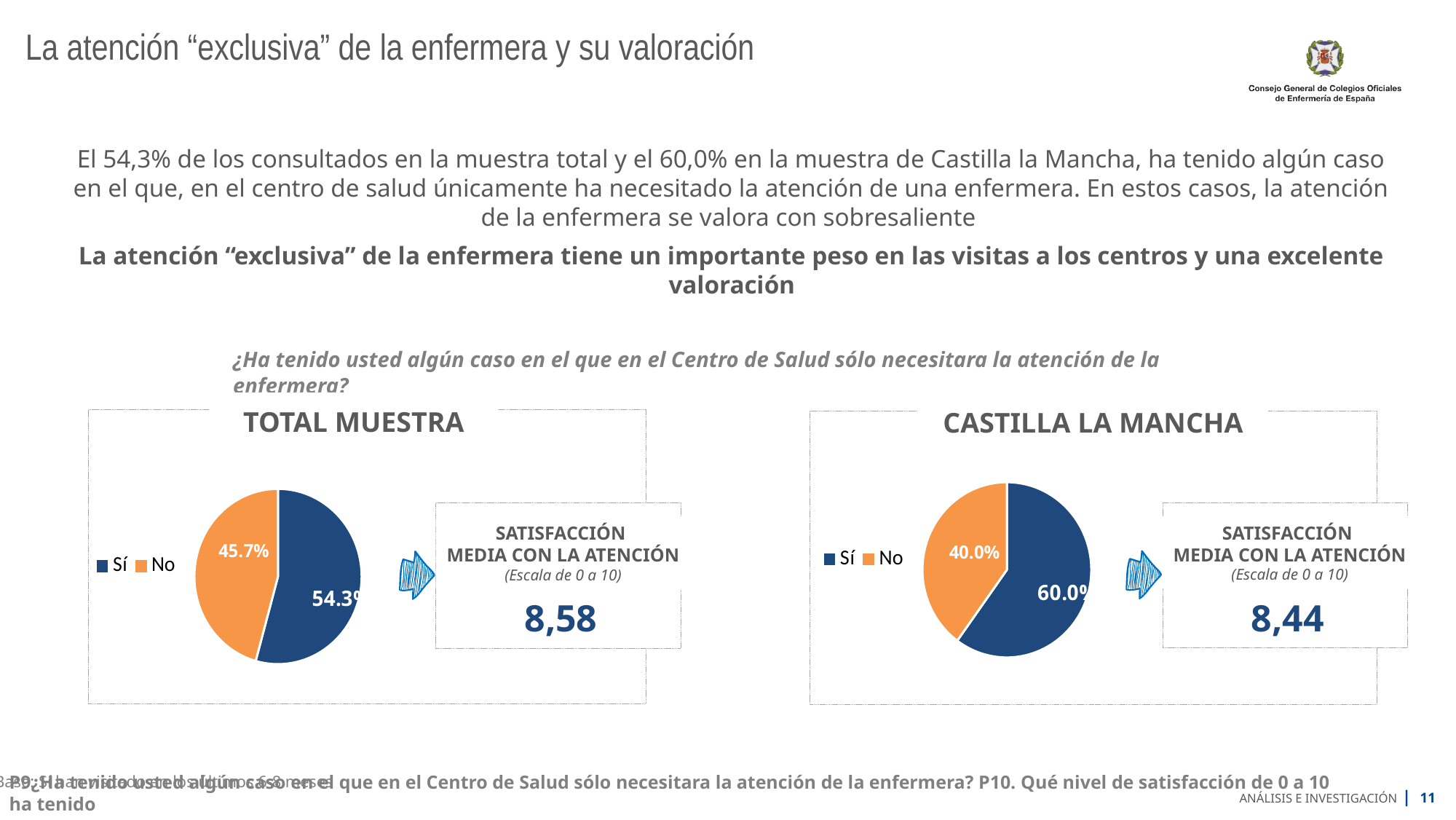
What type of chart is used under TOTAL MUESTRA? Pie chart How many slices does the CASTILLA LA MANCHA pie chart have? 2 In the CASTILLA LA MANCHA pie chart, what is the value for No? 40.0% In the CASTILLA LA MANCHA pie chart, what is the value for Sí? 60.0% In the TOTAL MUESTRA pie chart, what is the value for Sí? 54.3% Is the Sí slice larger in the TOTAL MUESTRA chart or in the CASTILLA LA MANCHA chart? CASTILLA LA MANCHA In the TOTAL MUESTRA pie chart, which slice is the smallest? No In the CASTILLA LA MANCHA pie chart, what is the difference between the Sí and No slices? 20.0% In the CASTILLA LA MANCHA pie chart, which slice is the largest? Sí In the TOTAL MUESTRA pie chart, what is the difference between the Sí and No slices? 8.6% In the TOTAL MUESTRA pie chart, what is the value for No? 45.7% In the TOTAL MUESTRA pie chart, what colour is the Sí slice? Dark blue